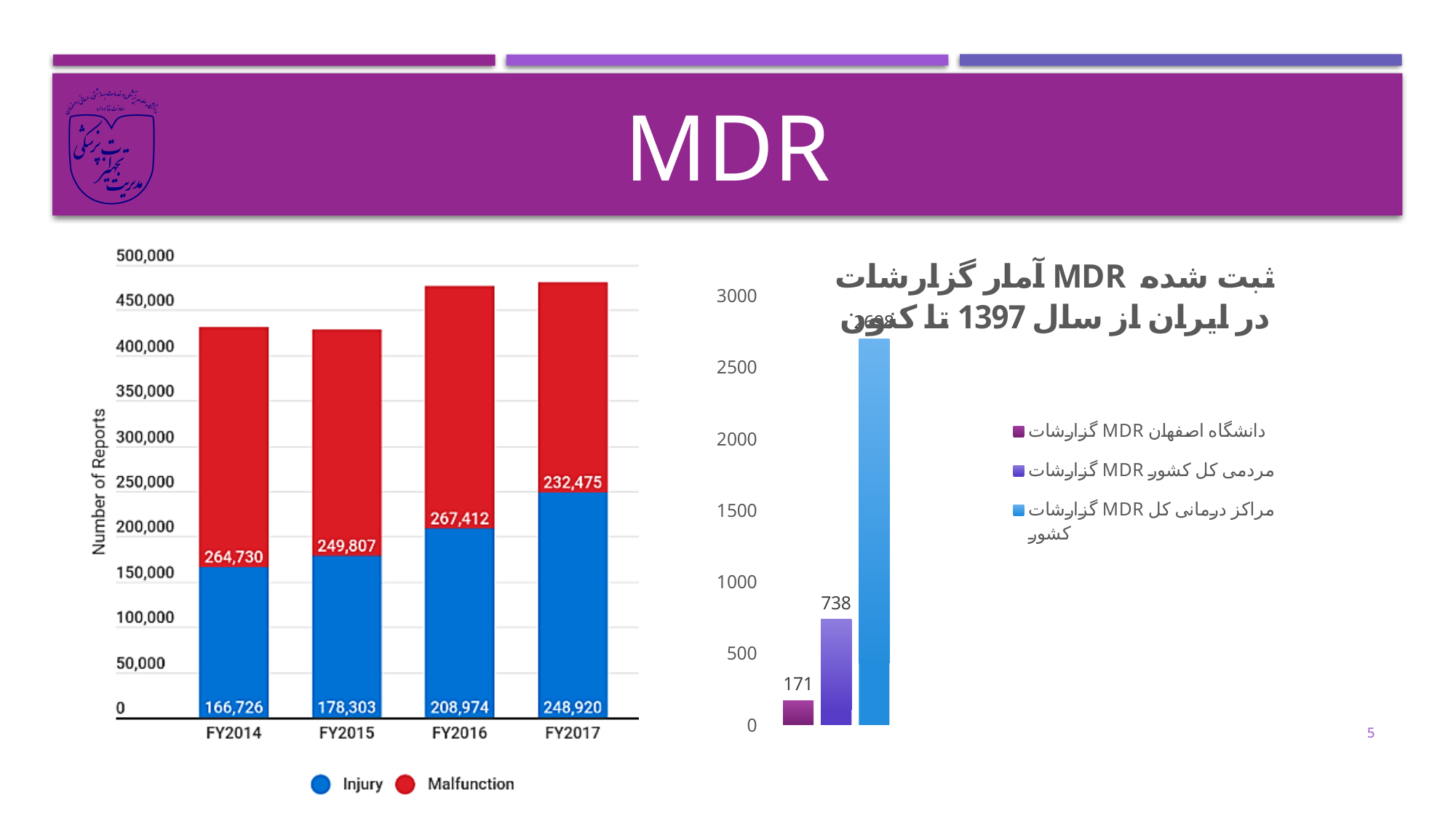
In the right chart, what is the value for the public nationwide MDR reports (مردمی کل کشور) bar? 738 In the left chart, do the Injury values rise or fall from FY2014 to FY2017? Rise In the left chart, what is the Malfunction value for FY2015? 249,807 How many series does the legend of the left chart list? 2 In the left chart, which fiscal year has the lowest Malfunction value? FY2017 In the right chart, is the value for the nationwide treatment centres MDR reports (مراکز درمانی کل کشور) bar greater or less than 2500? greater In the left chart, which fiscal year has the highest Injury value? FY2017 In the left chart, what is the difference between the Injury values for FY2017 and FY2014? 82,194 In the left chart, is the Malfunction value for FY2016 larger than the Malfunction value for FY2017? Yes In the left chart, what is the Injury value for FY2017? 248,920 In the right chart, what is the value for the Isfahan University MDR reports (دانشگاه اصفهان) bar? 171 In the left chart, what is the total of the stacked bar for FY2016? 476,386